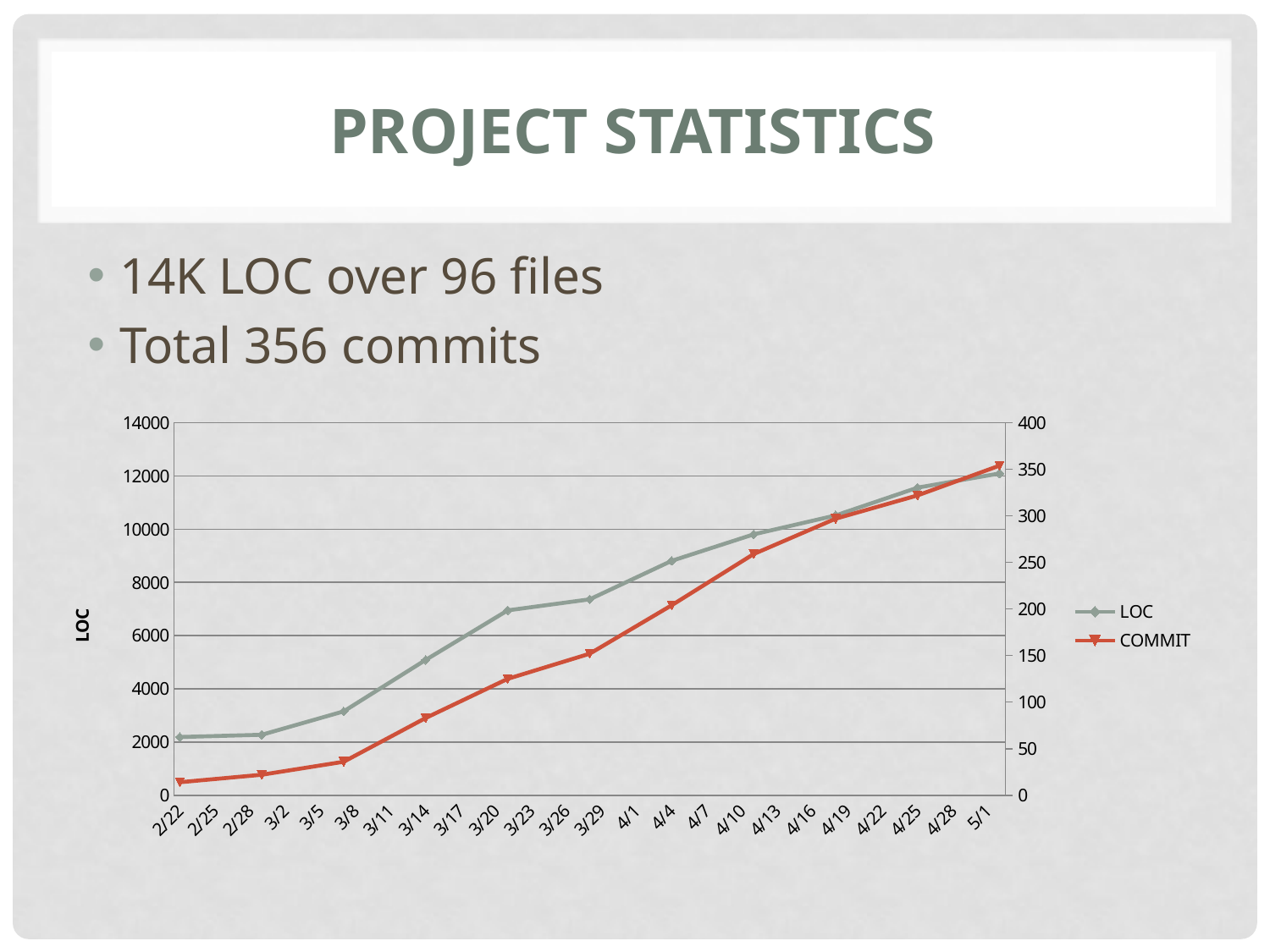
Is the COMMIT value at 4/4 greater or less than 150? greater What are the names of the two series in the chart legend? LOC and COMMIT What is the title of the left vertical axis of the chart? LOC On which date is the COMMIT series at its lowest? 2/22 Is the COMMIT value at 3/8 greater or less than 50? less Do the COMMIT values rise or fall over the dates shown? Rise What kind of chart is shown on the slide? Line chart On which date is the LOC series at its highest? 5/1 Do the LOC values rise or fall from 2/22 to 5/1? Rise Is the LOC value at 2/22 greater or less than 4000? less How many series does the chart legend list? 2